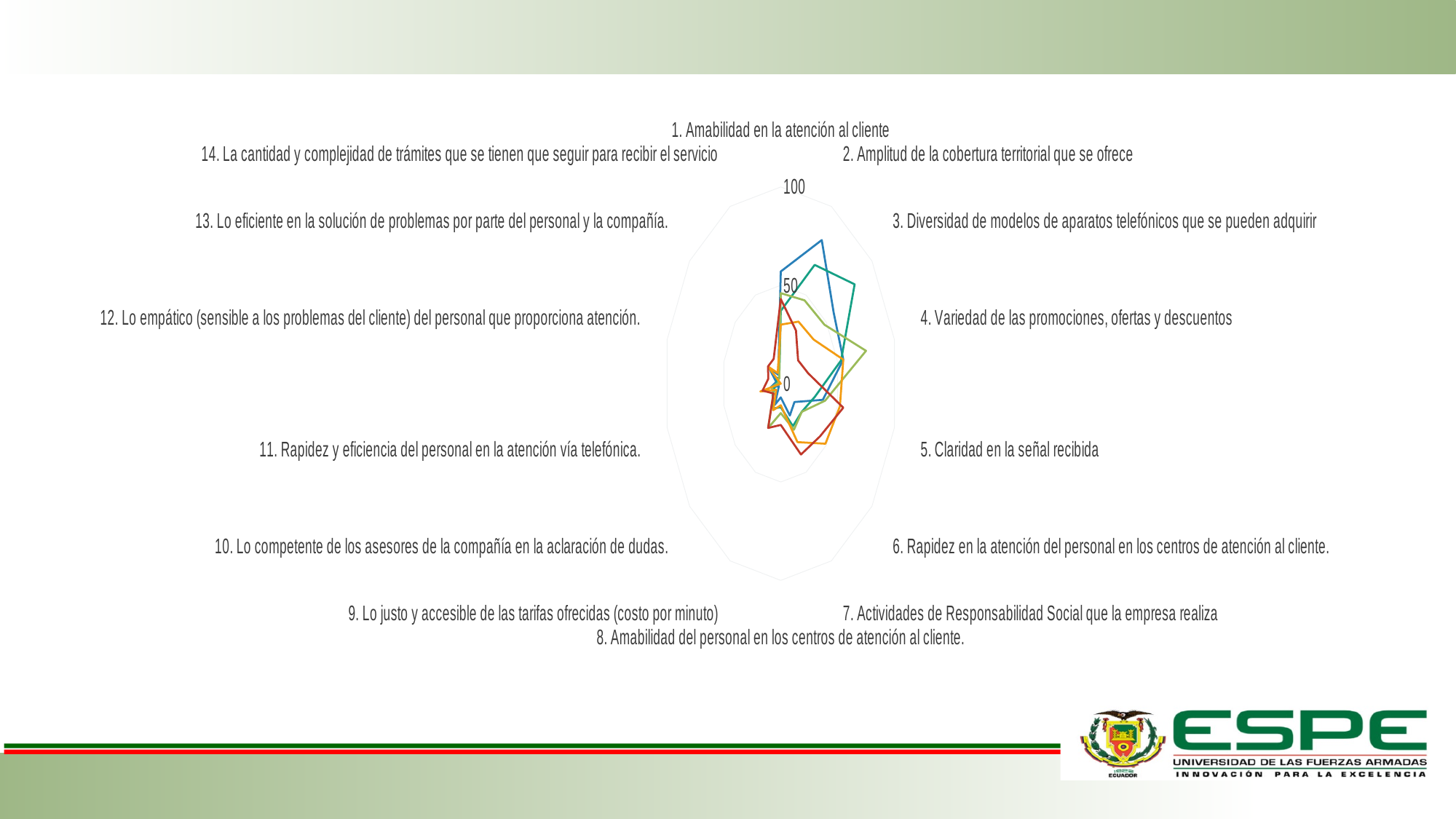
Is the blue series' value for "8. Amabilidad del personal en los centros de atención al cliente." greater or less than 50? less What is the label of the category at the top of the radar chart? 1. Amabilidad en la atención al cliente How many categories (axes) does the radar chart have? 14 Is the green series' value for "4. Variedad de las promociones, ofertas y descuentos" greater or less than 50? greater Is the blue series' value for "1. Amabilidad en la atención al cliente" greater or less than 50? greater What is the highest value marked on the radar chart's axis? 100 What kind of chart is shown on the slide? radar chart